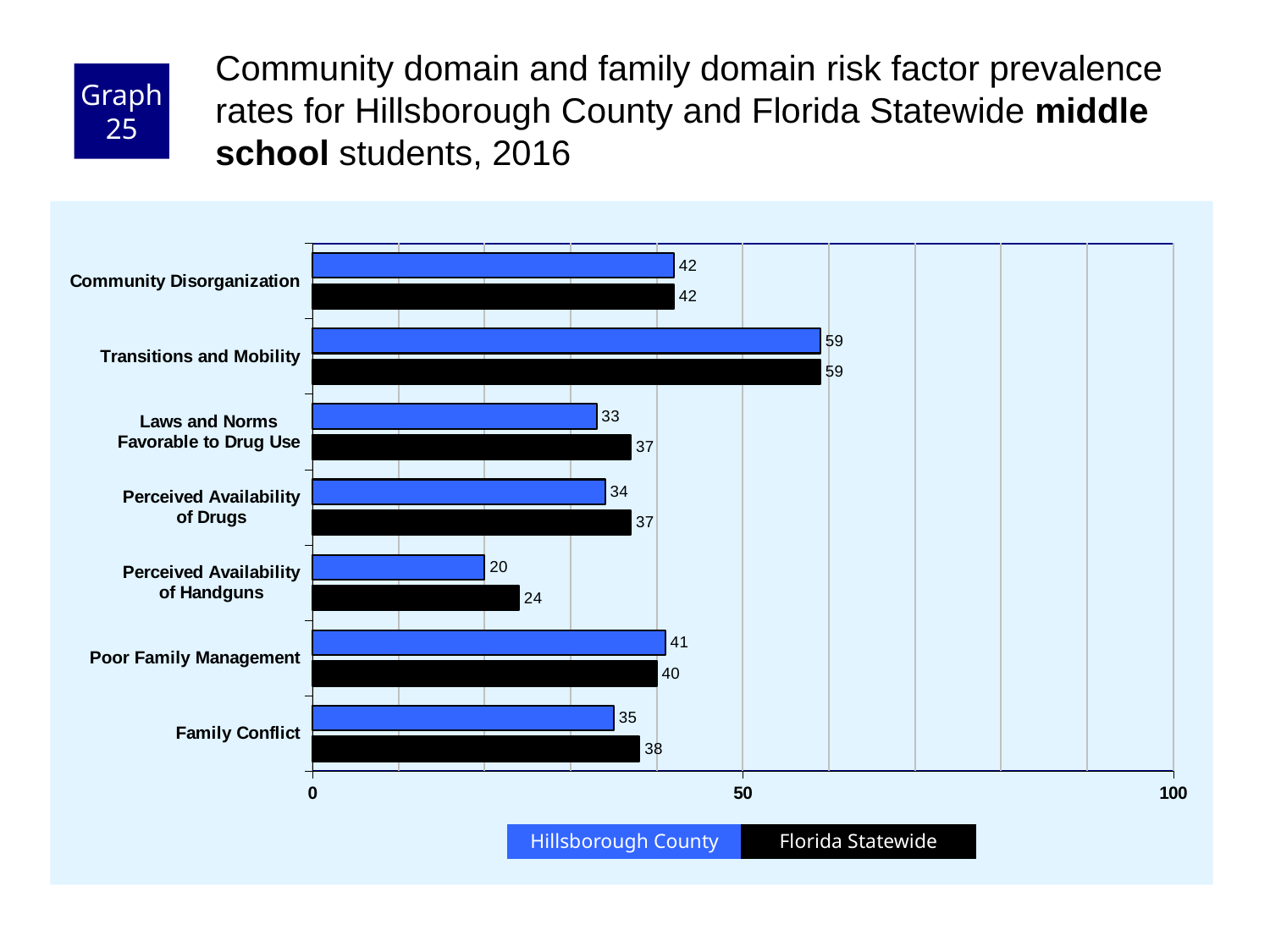
Is the Florida Statewide value for Transitions and Mobility greater or less than 50? greater Which risk factor has the lowest Hillsborough County value? Perceived Availability of Handguns What is the difference between the Florida Statewide and Hillsborough County values for Perceived Availability of Handguns? 4 What is the difference between the Hillsborough County values for Transitions and Mobility and Family Conflict? 24 For Poor Family Management, which is larger: the Hillsborough County value or the Florida Statewide value? Hillsborough County How many risk factor categories are shown on the chart? 7 How many series does the legend list? 2 What is the Hillsborough County value for Transitions and Mobility? 59 What is the Hillsborough County value for Laws and Norms Favorable to Drug Use? 33 What is the Florida Statewide value for Perceived Availability of Handguns? 24 Which risk factor has the highest Florida Statewide value? Transitions and Mobility What kind of chart is shown on the slide? Bar chart